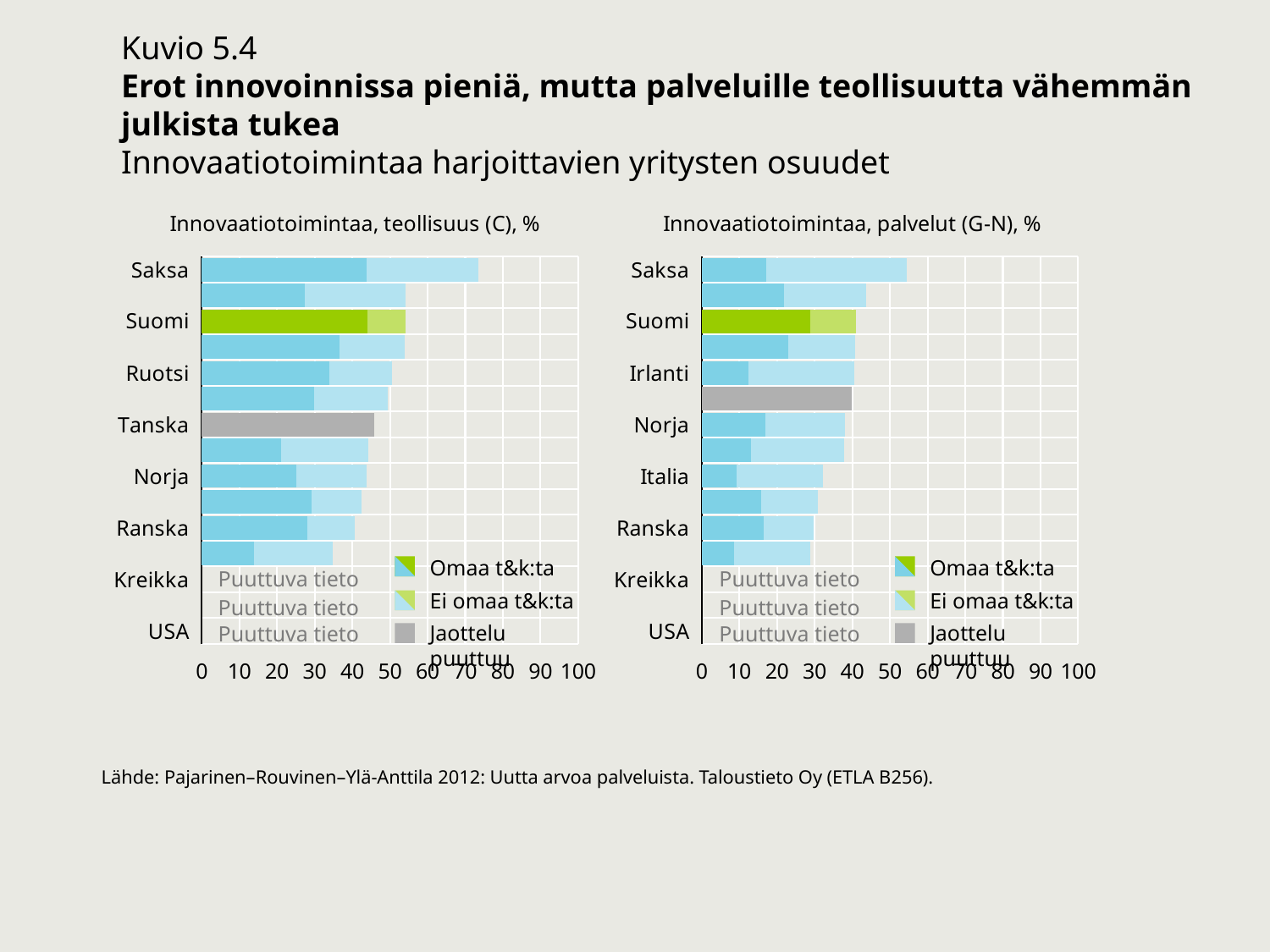
In the left chart, 'Innovaatiotoimintaa, teollisuus (C), %', is the total value for Saksa greater or less than 60? greater In the right chart, 'Innovaatiotoimintaa, palvelut (G-N), %', is the total value for Ranska greater or less than 40? less In the left chart, 'Innovaatiotoimintaa, teollisuus (C), %', which has the longer bar, Saksa or Suomi? Saksa What are the three legend entries of the right chart, 'Innovaatiotoimintaa, palvelut (G-N), %'? Omaa t&k:ta, Ei omaa t&k:ta, Jaottelu puuttuu In the left chart, 'Innovaatiotoimintaa, teollisuus (C), %', is the grey bar for Tanska greater or less than 50? less In the left chart, 'Innovaatiotoimintaa, teollisuus (C), %', what text is shown instead of bars for Kreikka and USA? Puuttuva tieto In the right chart, 'Innovaatiotoimintaa, palvelut (G-N), %', which country has the longest bar? Saksa How many series does the legend of the right chart, 'Innovaatiotoimintaa, palvelut (G-N), %', list? 3 What kind of chart is the left chart, 'Innovaatiotoimintaa, teollisuus (C), %'? bar chart In the left chart, 'Innovaatiotoimintaa, teollisuus (C), %', which country has the longest bar? Saksa In the right chart, 'Innovaatiotoimintaa, palvelut (G-N), %', which has the longer bar, Saksa or Italia? Saksa